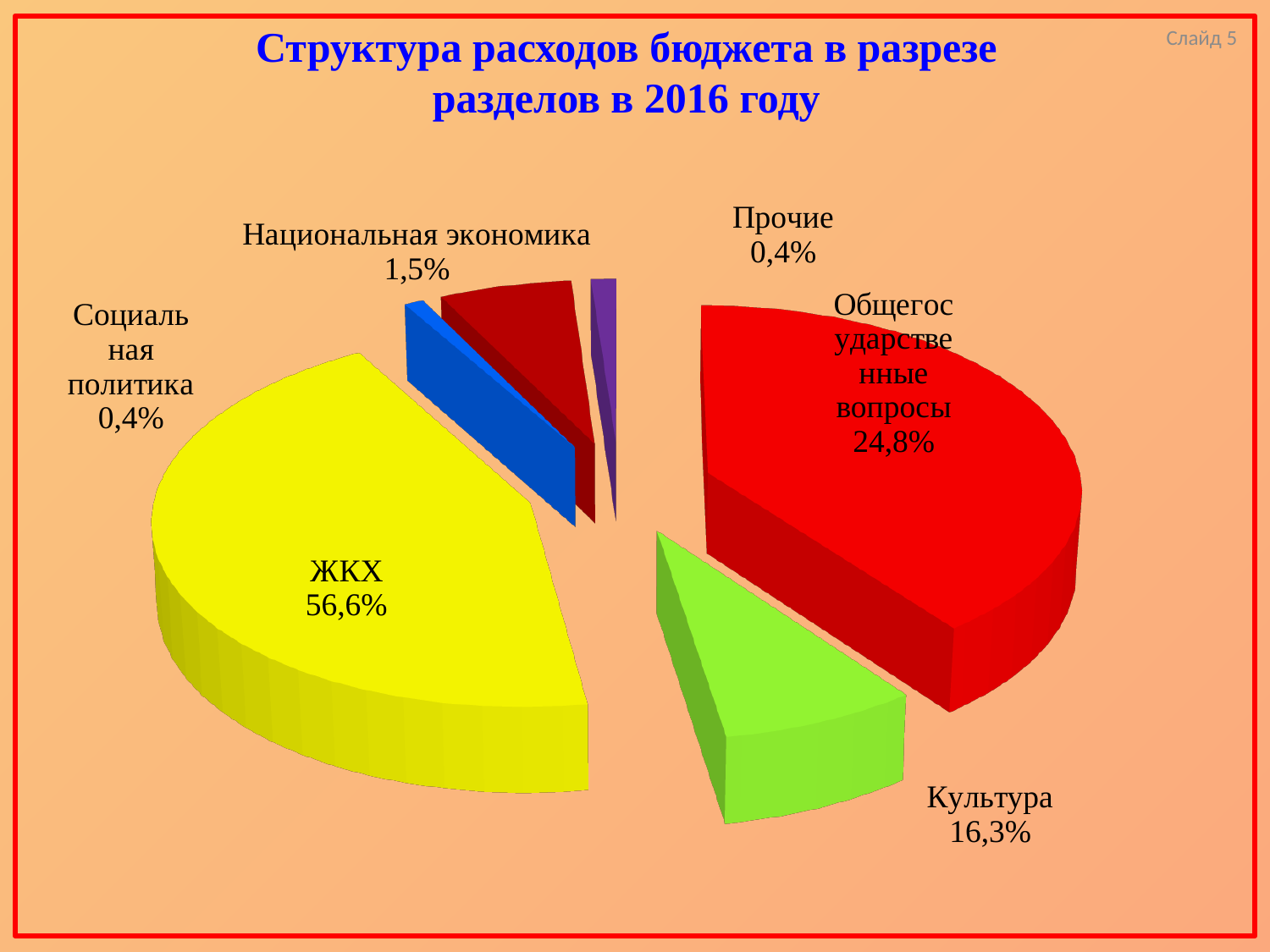
Which is larger, the share of Культура or the share of Общегосударственные вопросы? Общегосударственные вопросы What is the value shown for Национальная экономика? 1,5% What is the value shown for Общегосударственные вопросы? 24,8% Which section has the largest share of budget expenditure? ЖКХ How many sections (slices) are shown in the pie chart? 6 What is the value shown for Культура? 16,3% What share of budget expenditure does ЖКХ account for? 56,6% What kind of chart is shown on the slide? pie chart What is the value shown for Прочие? 0,4% What is the title of the chart? Структура расходов бюджета в разрезе разделов в 2016 году What is the difference between the shares of ЖКХ and Общегосударственные вопросы? 31,8% What is the difference between the shares of Общегосударственные вопросы and Культура? 8,5%